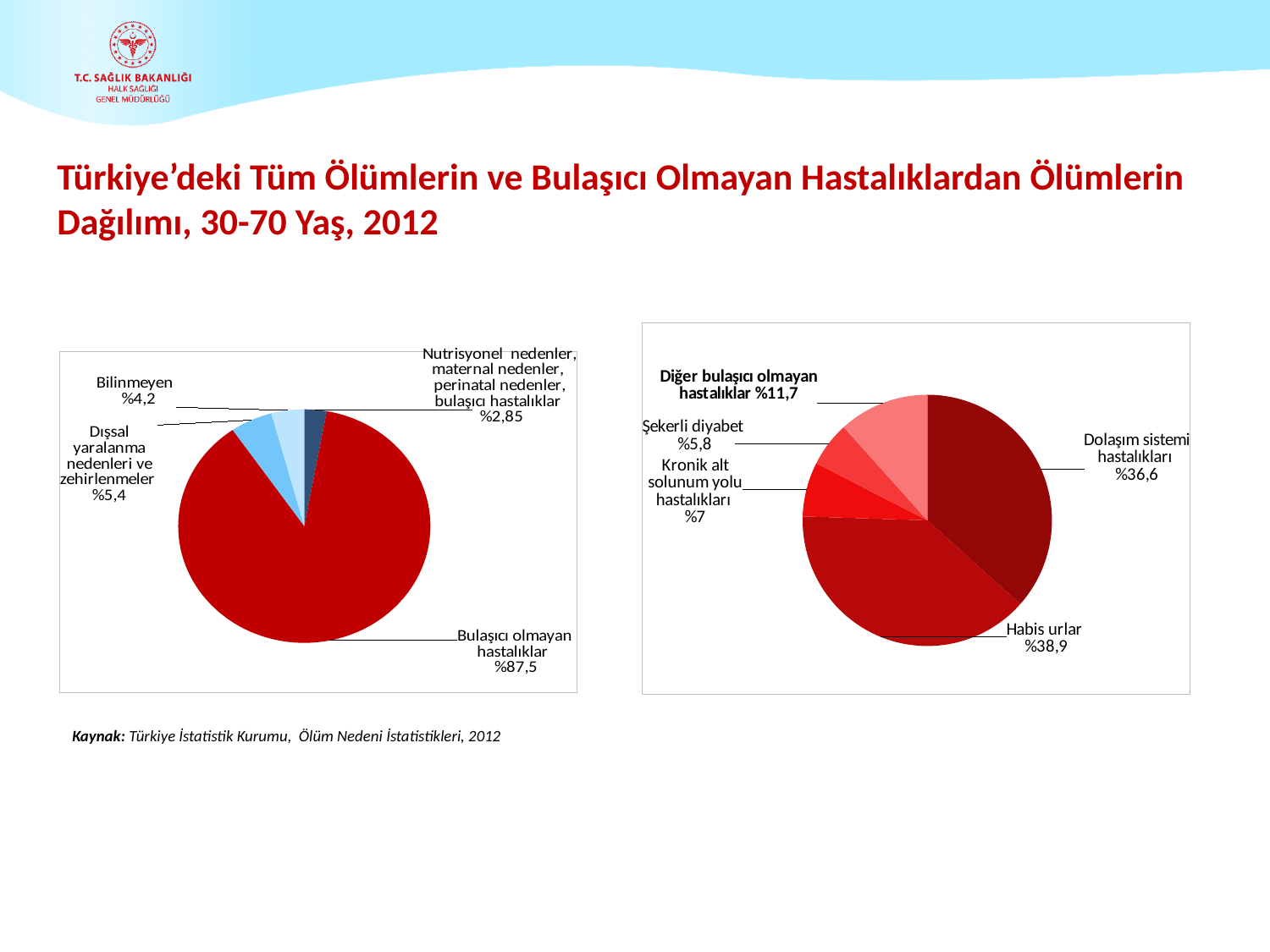
In the right pie chart, what is the difference between Habis urlar and Dolaşım sistemi hastalıkları? %2,3 In the left pie chart, which category has the smallest slice? Nutrisyonel nedenler, maternal nedenler, perinatal nedenler, bulaşıcı hastalıklar In the right pie chart, what is the value for Habis urlar? %38,9 In the left pie chart, what is the value for Dışsal yaralanma nedenleri ve zehirlenmeler? %5,4 In the right pie chart, what is the value for Kronik alt solunum yolu hastalıkları? %7 In the right pie chart, which category has the smallest share? Şekerli diyabet In the right pie chart, which category has the largest share? Habis urlar In the left pie chart, what share of deaths is attributed to Bulaşıcı olmayan hastalıklar? %87,5 In the right pie chart, which is larger: Diğer bulaşıcı olmayan hastalıklar or Şekerli diyabet? Diğer bulaşıcı olmayan hastalıklar In the left pie chart, what is the value for Bilinmeyen? %4,2 In the left pie chart, how many slices are there? 4 What type of chart is used on the right side of the slide? Pie chart